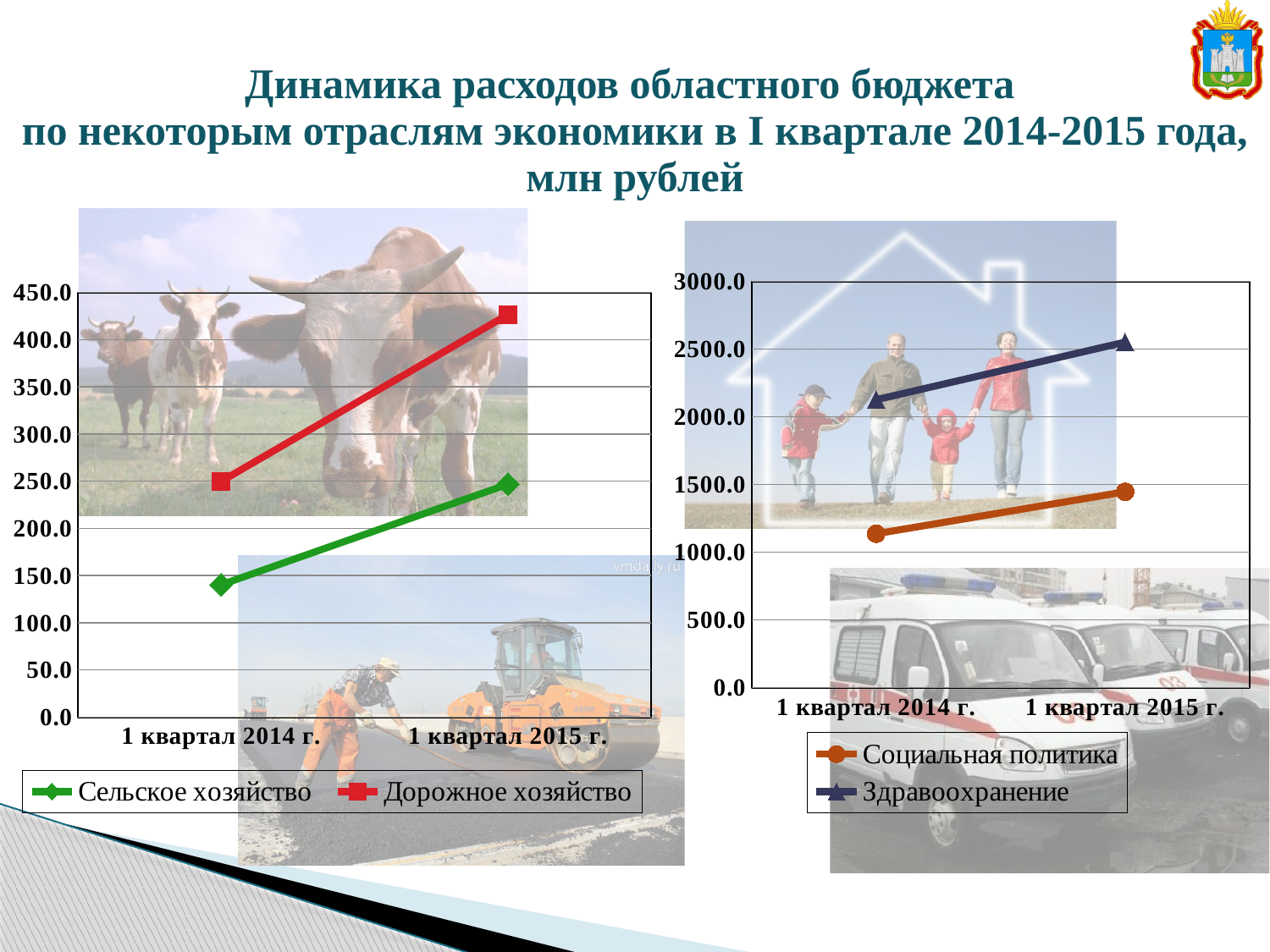
Which series in the right chart is drawn with triangle markers? Здравоохранение What kind of chart is the right chart on the slide? line chart In the right chart, is the value for Здравоохранение in 1 квартал 2015 г. greater or less than 2500.0? greater What kind of chart is the left chart on the slide? line chart How many series does the legend of the left chart list? 2 In the left chart, which series has the higher value in 1 квартал 2015 г., Сельское хозяйство or Дорожное хозяйство? Дорожное хозяйство How many categories are shown on the x axis of the left chart? 2 In the left chart, does the value for Дорожное хозяйство rise or fall from 1 квартал 2014 г. to 1 квартал 2015 г.? rise In the left chart, is the value for Дорожное хозяйство in 1 квартал 2015 г. greater or less than 400.0? greater In the right chart, which series has the higher value in 1 квартал 2014 г., Социальная политика or Здравоохранение? Здравоохранение In the right chart, does the value for Социальная политика rise or fall from 1 квартал 2014 г. to 1 квартал 2015 г.? rise How many series does the legend of the right chart list? 2